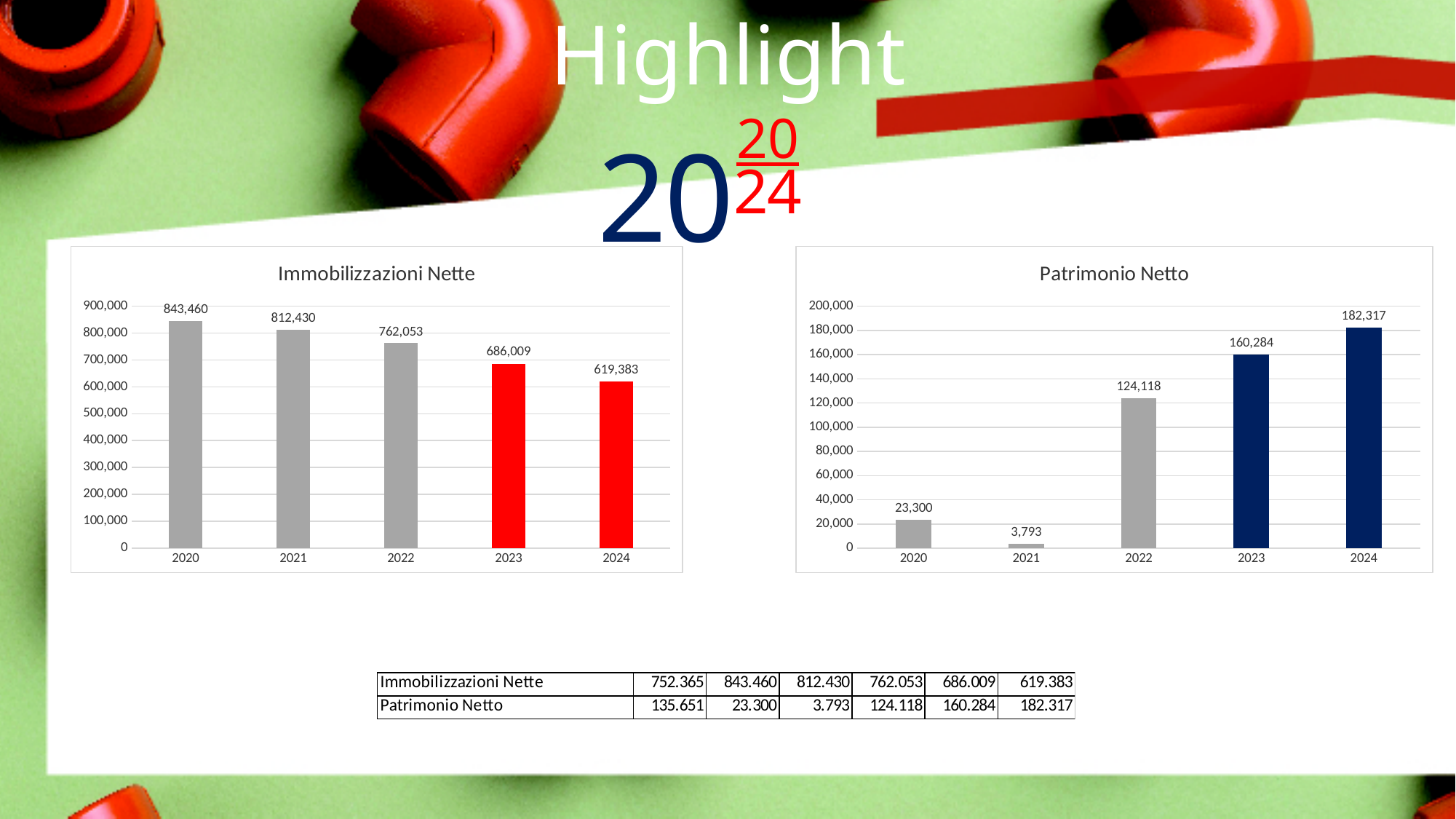
In the Patrimonio Netto chart, what is the difference between the 2024 and 2023 values? 22,033 In the Immobilizzazioni Nette chart, do the values rise or fall from 2020 to 2024? fall In the Patrimonio Netto chart, what colour are the bars for 2023 and 2024? dark blue How many years are shown on the x axis of the Patrimonio Netto chart? 5 In the Immobilizzazioni Nette chart, what is the difference between the 2020 and 2024 values? 224,077 In the Immobilizzazioni Nette chart, what is the value for 2022? 762,053 In the Immobilizzazioni Nette chart, is the value for 2023 greater or less than 700,000? less In the Patrimonio Netto chart, which is larger, the value for 2020 or the value for 2022? 2022 In the Patrimonio Netto chart, what is the value for 2023? 160,284 What kind of chart is the Immobilizzazioni Nette chart? bar chart In the Patrimonio Netto chart, which year has the lowest value? 2021 In the Immobilizzazioni Nette chart, which year has the highest value? 2020